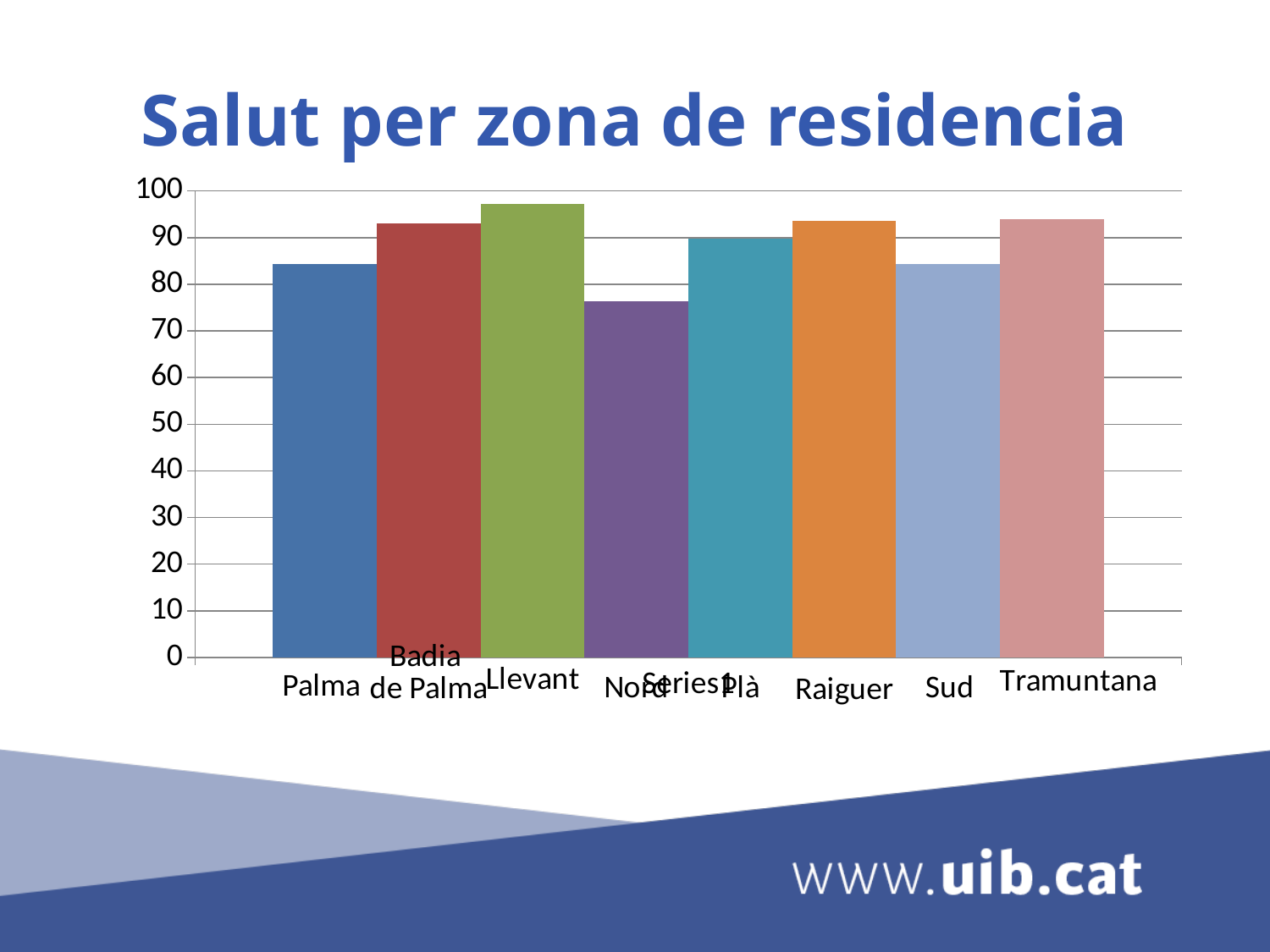
Which has the larger value, Badia de Palma or Nord? Badia de Palma Which zone has the lowest value? Nord Which has the larger value, Tramuntana or Sud? Tramuntana Is the value for Sud greater or less than 90? less What kind of chart is shown on the slide? bar chart Is the value for Nord greater or less than 80? less Is the value for Palma greater or less than 80? greater Which zone has the highest value? Llevant How many zones (bars) are shown in the chart? 8 What is the title of the chart? Salut per zona de residencia